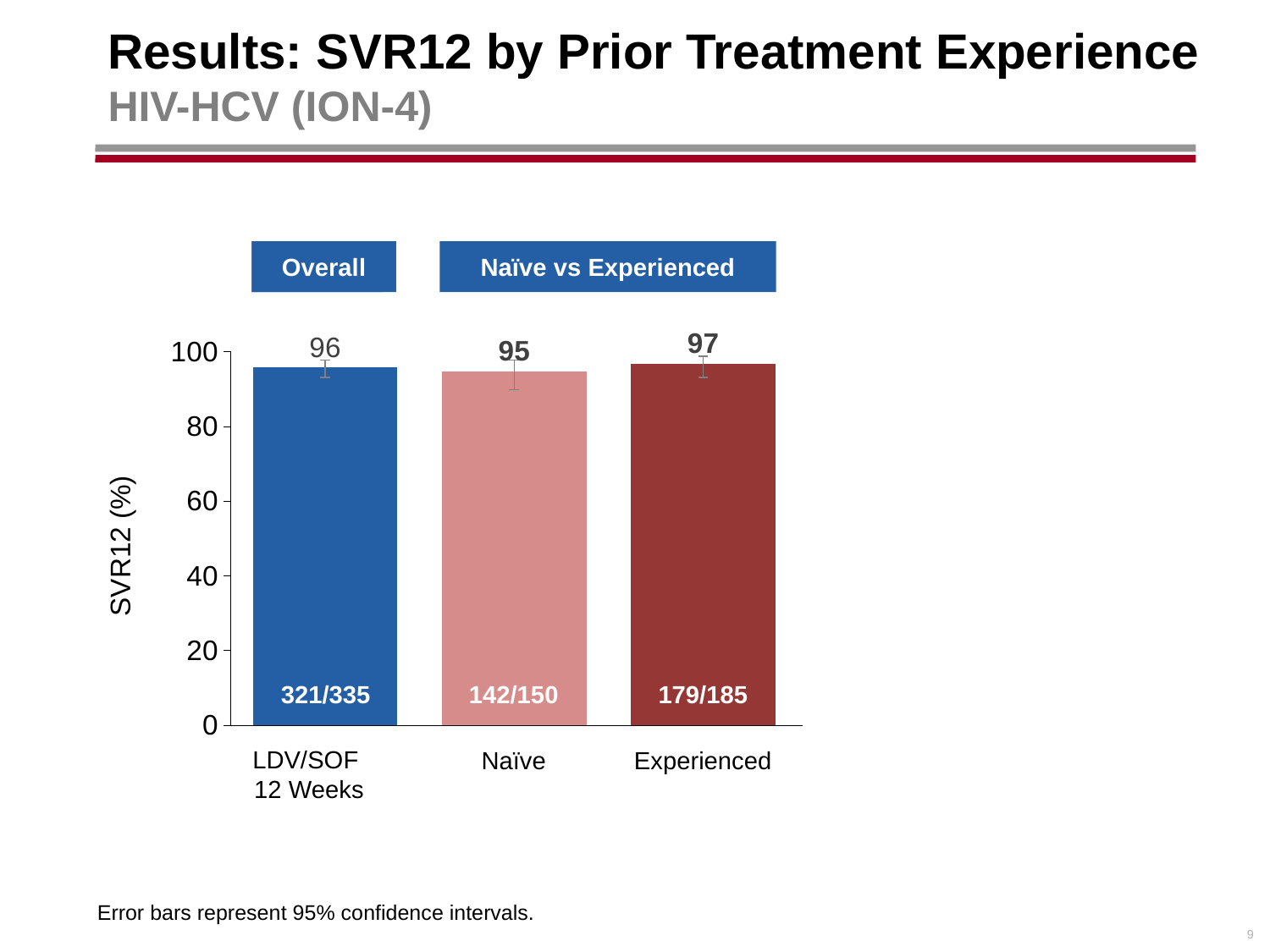
How many bars are shown in the chart? 3 What fraction of patients is printed on the LDV/SOF 12 Weeks bar? 321/335 What is the SVR12 value for the Experienced group? 97 What fraction of patients is printed on the Naïve bar? 142/150 What type of chart is shown on the slide? Bar chart What is the SVR12 value for LDV/SOF 12 Weeks overall? 96 What is the label of the y axis? SVR12 (%) Which has a higher SVR12, the Naïve group or the Experienced group? Experienced What is the SVR12 value for the Naïve group? 95 Which group has the lowest SVR12 value? Naïve Which group has the highest SVR12 value? Experienced What is the difference in SVR12 between the Experienced and Naïve groups? 2